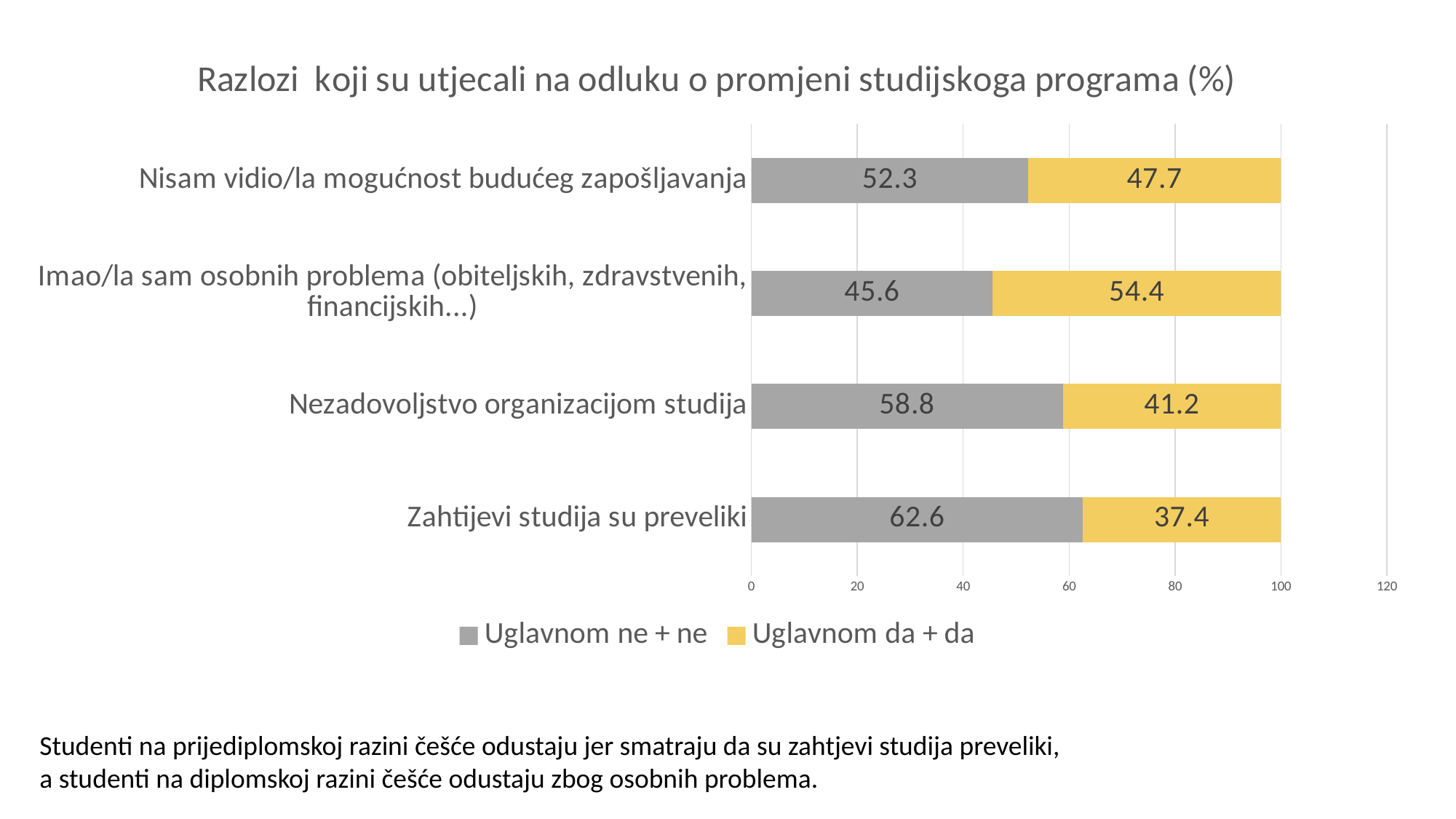
Which category has the lowest value for "Uglavnom ne + ne"? Imao/la sam osobnih problema (obiteljskih, zdravstvenih, financijskih...) What is the value of "Uglavnom da + da" for "Imao/la sam osobnih problema (obiteljskih, zdravstvenih, financijskih...)"? 54.4 What kind of chart is shown on the slide? Stacked bar chart For "Nisam vidio/la mogućnost budućeg zapošljavanja", which is larger: "Uglavnom ne + ne" or "Uglavnom da + da"? Uglavnom ne + ne What is the total of the stacked bar for "Nisam vidio/la mogućnost budućeg zapošljavanja"? 100 Which category has the highest value for "Uglavnom da + da"? Imao/la sam osobnih problema (obiteljskih, zdravstvenih, financijskih...) What is the value of "Uglavnom da + da" for "Nezadovoljstvo organizacijom studija"? 41.2 What is the difference between the "Uglavnom ne + ne" and "Uglavnom da + da" values for "Zahtijevi studija su preveliki"? 25.2 How many categories are shown in the chart? 4 What is the value of "Uglavnom ne + ne" for "Zahtijevi studija su preveliki"? 62.6 How many series does the legend list? 2 Is the "Uglavnom ne + ne" value for "Nezadovoljstvo organizacijom studija" greater or less than 40? greater